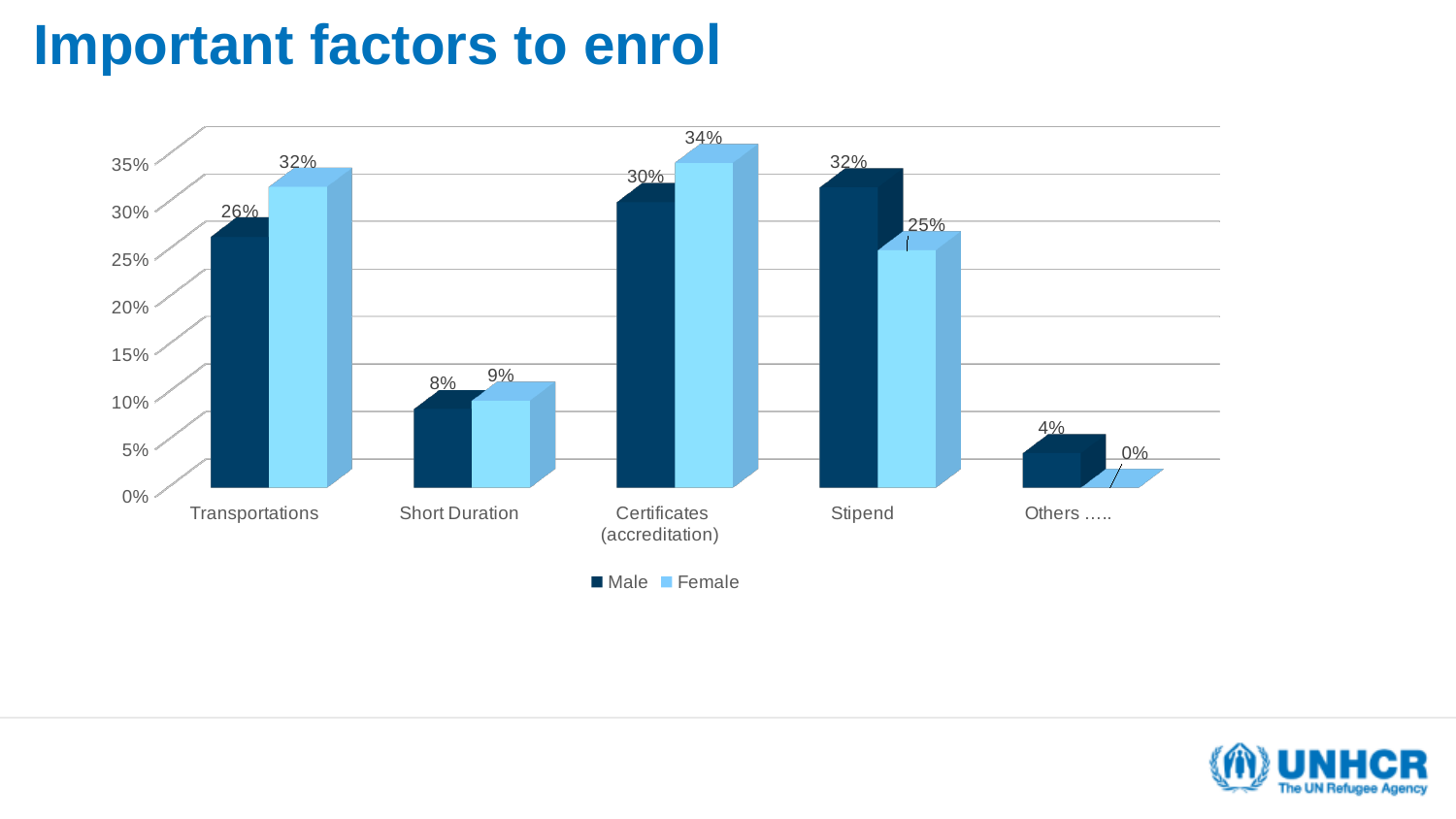
How many categories are shown on the x axis? 5 What is the Female value for Certificates (accreditation)? 34% Which is larger for Stipend, the Male value or the Female value? Male What is the Male value for Others …..? 4% What is the Female value for Stipend? 25% Which category has the lowest Male value? Others ….. What is the Male value for Transportations? 26% Which category has the highest Female value? Certificates (accreditation) What kind of chart is shown on the slide? Bar chart What is the difference between the Female and Male values for Transportations? 6% How many series does the legend list? 2 What is the title of the slide? Important factors to enrol